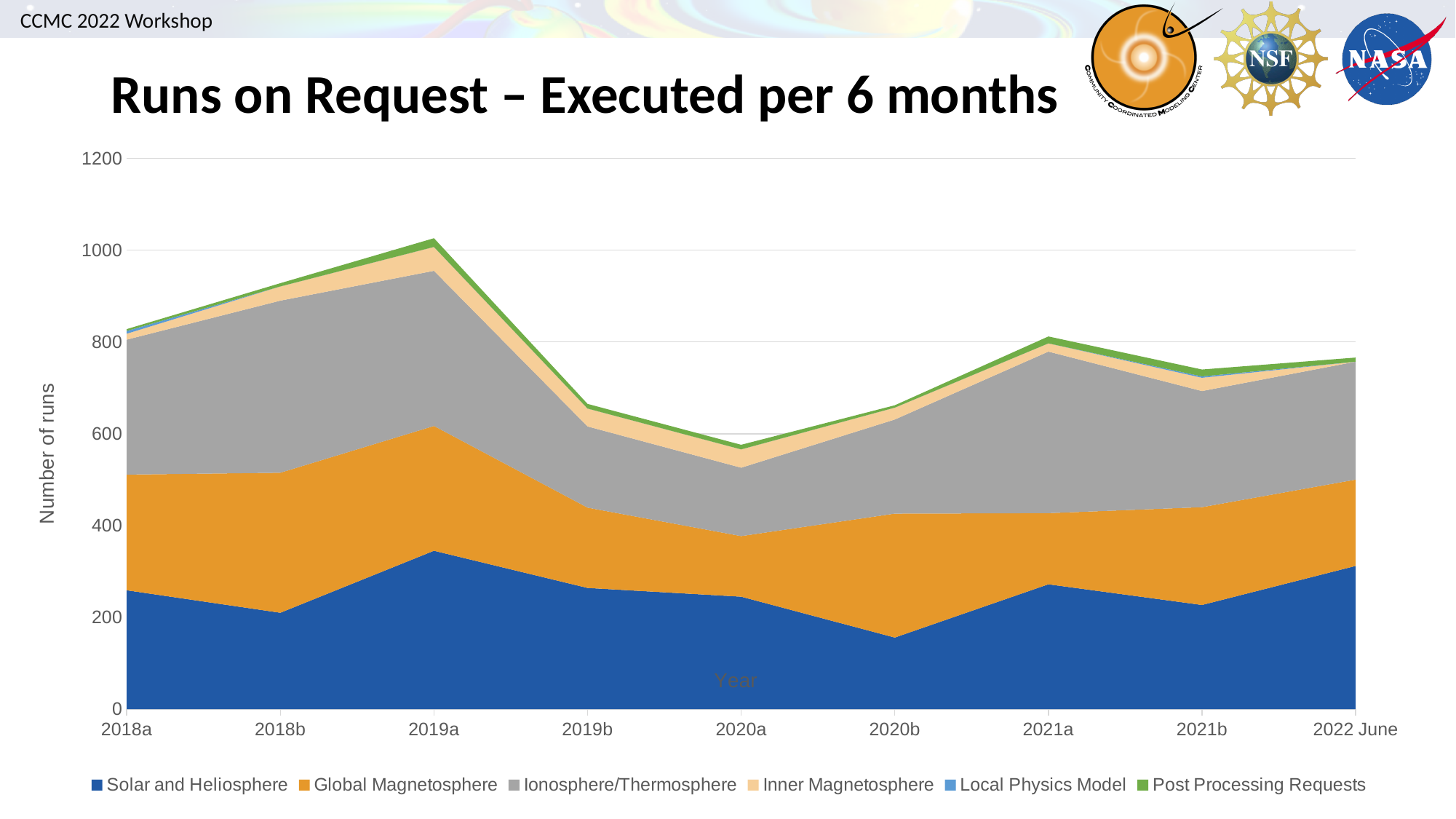
In which period is the Solar and Heliosphere value lowest? 2020b Is the Solar and Heliosphere value for 2019a greater or less than 200? greater Is the total number of runs for 2019b greater or less than 800? less Does the total number of runs rise or fall from 2020a to 2021a? rise In which period is the total number of runs lowest? 2020a How many series does the legend list? 6 How many time periods are shown along the x axis? 9 In which period is the total number of runs highest? 2019a What is the label on the vertical axis? Number of runs What kind of chart is shown on the slide? Stacked area chart Which period has a larger total number of runs, 2021a or 2021b? 2021a Is the Solar and Heliosphere value for 2020b greater or less than 200? less